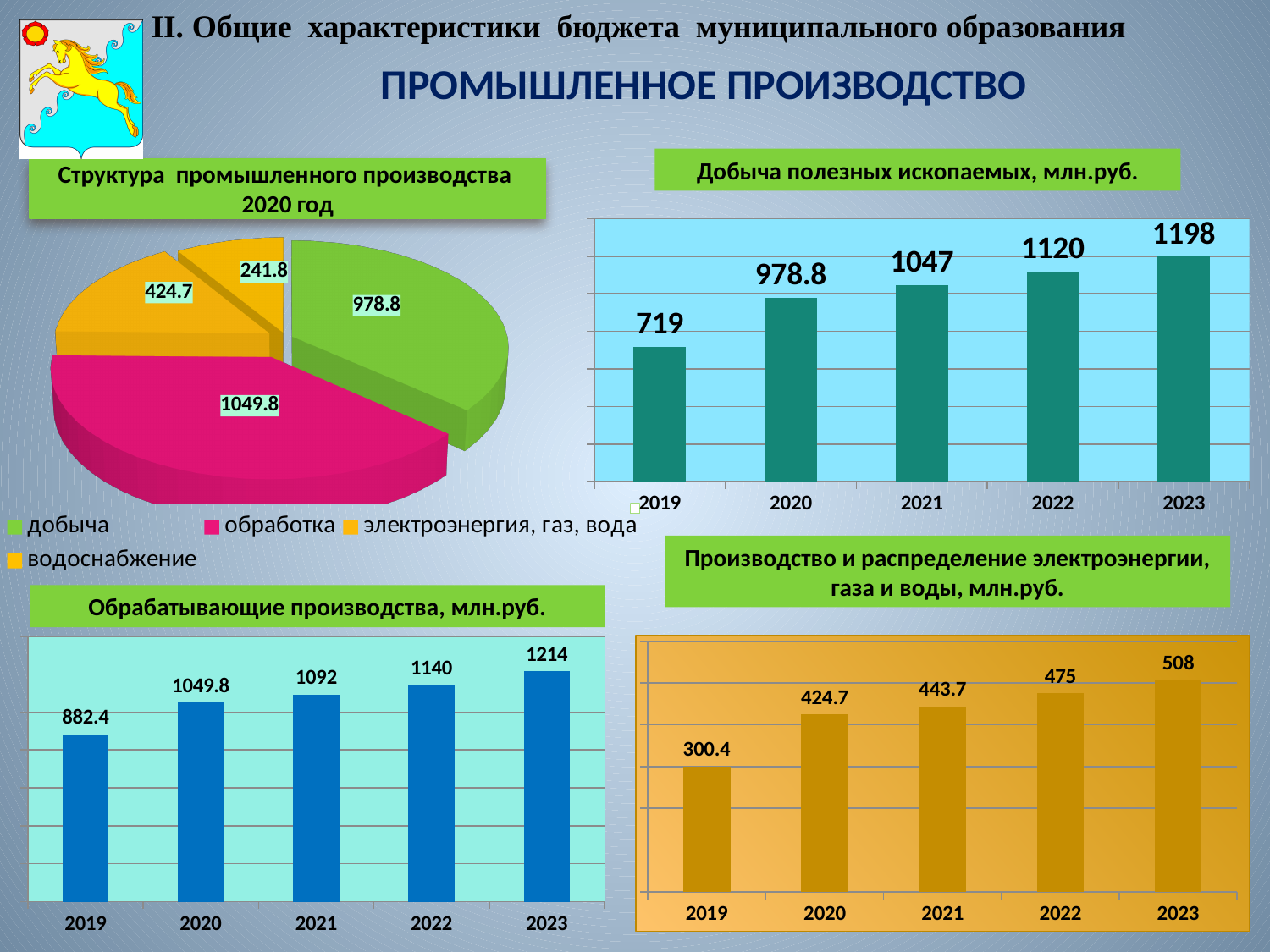
In the chart 'Добыча полезных ископаемых, млн.руб.', what is the value for 2021? 1047 In the chart 'Производство и распределение электроэнергии, газа и воды, млн.руб.', what is the difference between the 2022 and 2021 values? 31.3 What kind of chart is 'Добыча полезных ископаемых, млн.руб.'? bar chart In the chart 'Добыча полезных ископаемых, млн.руб.', which year has the lowest value? 2019 In the pie chart 'Структура промышленного производства 2020 год', what is the value for обработка? 1049.8 In the chart 'Обрабатывающие производства, млн.руб.', which year has the highest value? 2023 In the chart 'Добыча полезных ископаемых, млн.руб.', what is the difference between the 2023 and 2019 values? 479 In the chart 'Производство и распределение электроэнергии, газа и воды, млн.руб.', how many years are shown? 5 In the chart 'Обрабатывающие производства, млн.руб.', what is the value for 2020? 1049.8 In the chart 'Обрабатывающие производства, млн.руб.', do the values rise or fall from 2019 to 2023? rise In the chart 'Производство и распределение электроэнергии, газа и воды, млн.руб.', what is the value for 2019? 300.4 In the pie chart 'Структура промышленного производства 2020 год', which category has the smallest value? водоснабжение